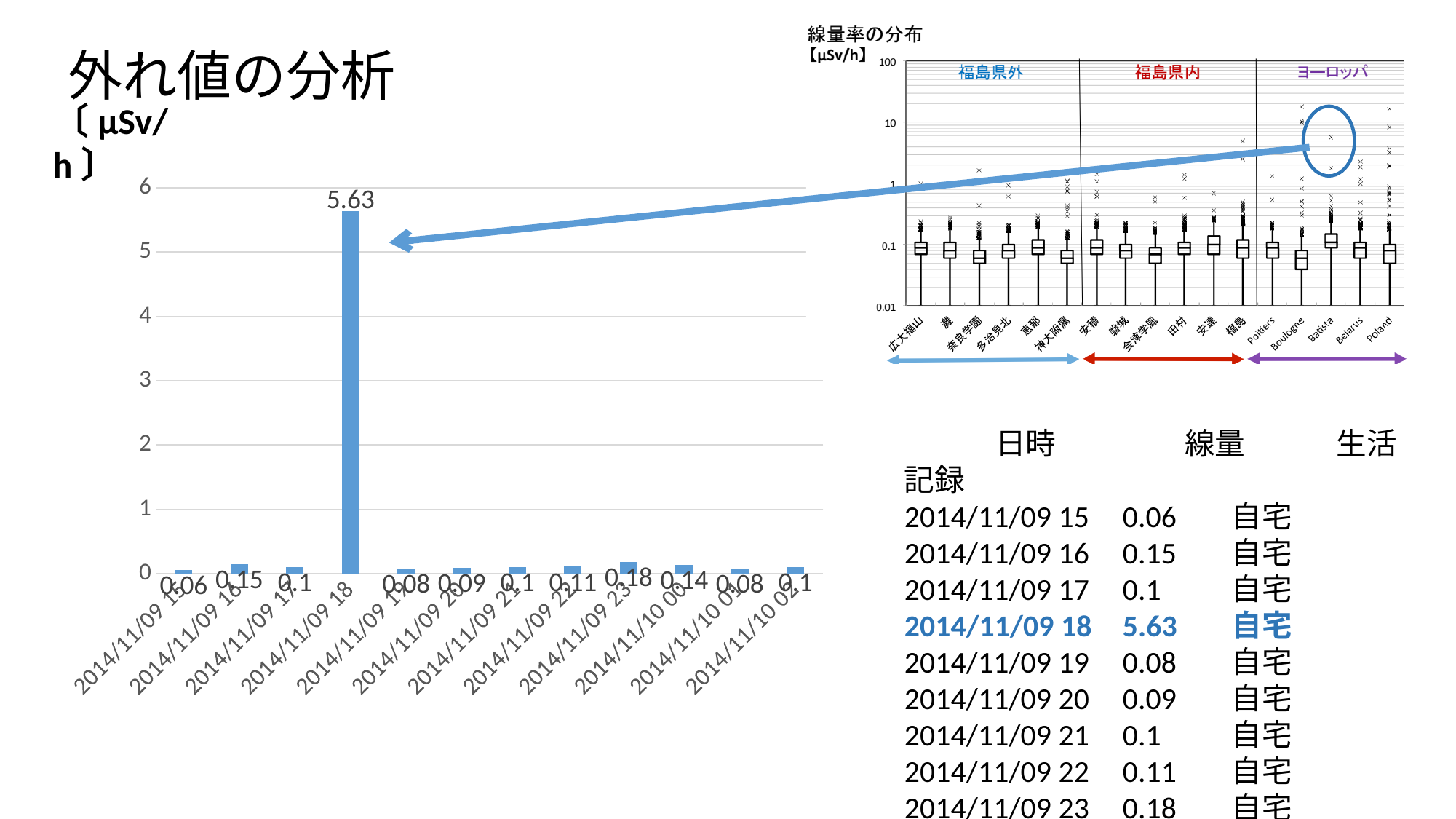
In the bar chart on the left, which is larger: the value for 2014/11/09 23 or the value for 2014/11/10 00? 2014/11/09 23 In the bar chart on the left, which time has the highest value? 2014/11/09 18 In the bar chart on the left, what is the difference between the values for 2014/11/09 23 and 2014/11/09 17? 0.08 In the bar chart on the left, is the value for 2014/11/09 18 greater or less than 5? greater In the bar chart on the left, what is the value for 2014/11/10 01? 0.08 In the bar chart on the left, what is the value for 2014/11/09 18? 5.63 How many time categories are shown on the x axis of the bar chart on the left? 12 What kind of chart is the chart on the left of the slide? bar chart In the bar chart on the left, which time has the lowest value? 2014/11/09 15 In the bar chart on the left, what is the value for 2014/11/09 23? 0.18 In the bar chart on the left, what is the difference between the values for 2014/11/09 18 and 2014/11/09 15? 5.57 In the box plot on the upper right (線量率の分布), which region group is circled? ヨーロッパ